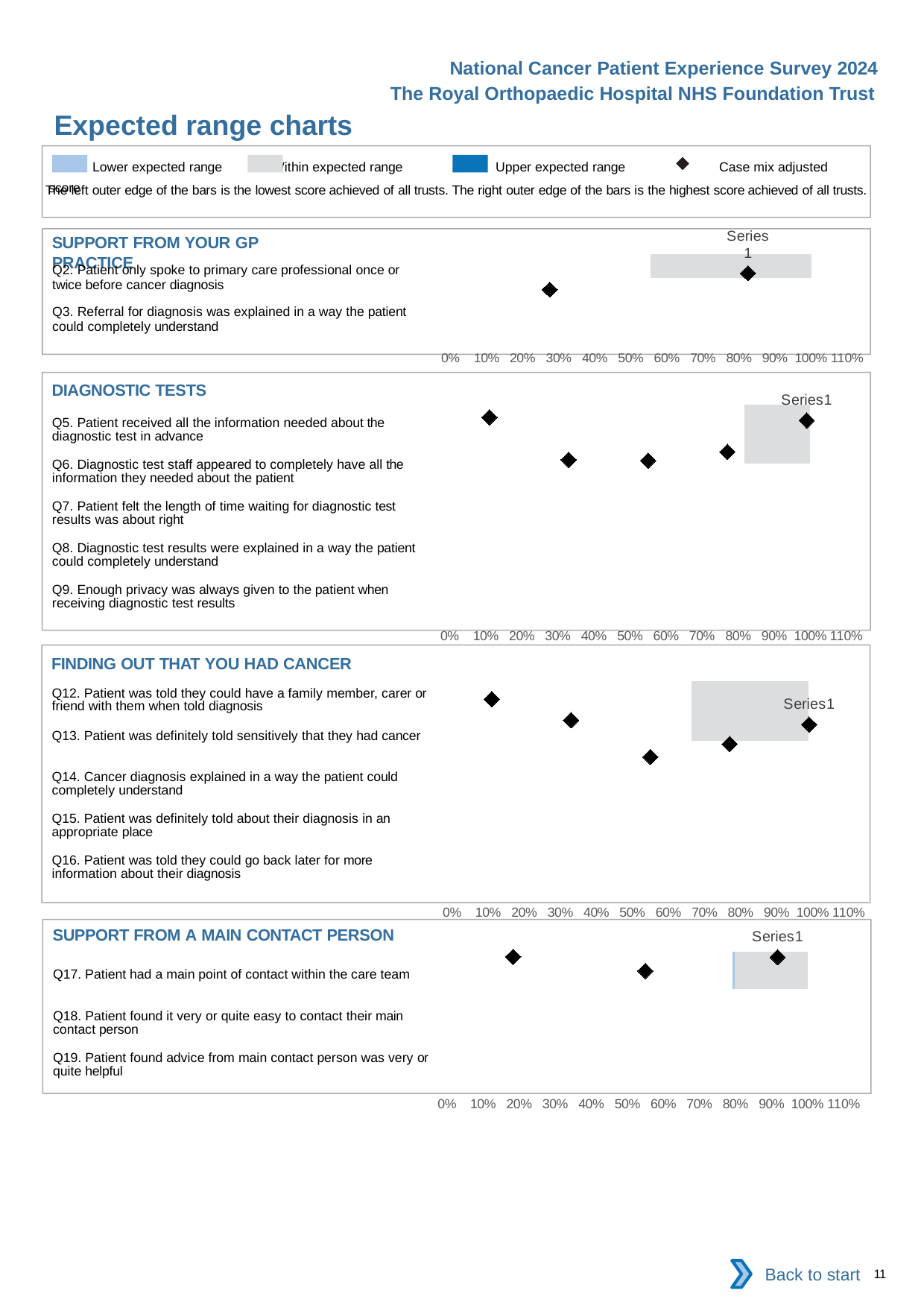
In the 'DIAGNOSTIC TESTS' chart, is the value of the leftmost diamond marker greater or less than 20%? less In the 'DIAGNOSTIC TESTS' chart, is the value of the rightmost diamond marker greater or less than 90%? greater How many question items are listed in the 'DIAGNOSTIC TESTS' chart? 5 What is the highest percentage tick shown on the x axis of the 'DIAGNOSTIC TESTS' chart? 110% In the 'SUPPORT FROM YOUR GP PRACTICE' chart, is the value of the rightmost diamond marker greater or less than 70%? greater How many diamond markers are plotted in the 'DIAGNOSTIC TESTS' chart? 5 How many question items are listed in the 'SUPPORT FROM A MAIN CONTACT PERSON' chart? 3 According to the legend at the top of the slide, what does the grey shading represent? Within expected range According to the legend at the top of the slide, what does the black diamond marker represent? Case mix adjusted score